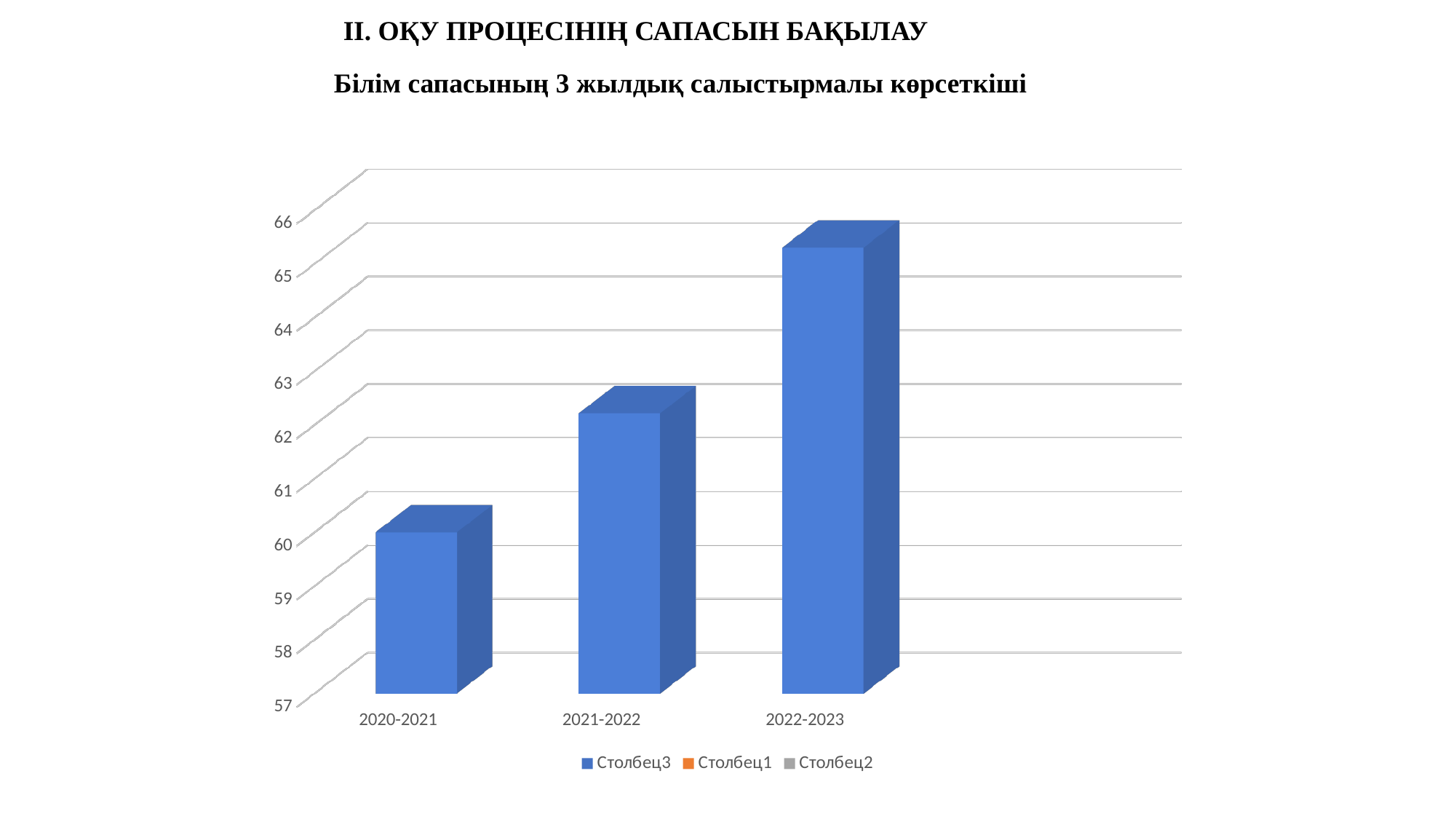
Which is larger, the value for 2021-2022 or the value for 2020-2021? 2021-2022 How many categories (academic years) are shown on the x axis? 3 Do the values rise or fall from 2020-2021 to 2022-2023? Rise Is the value for 2021-2022 greater or less than 61? greater What kind of chart is shown on the slide? Bar chart Is the value for 2022-2023 greater or less than 64? greater What is the title of the chart? Білім сапасының 3 жылдық салыстырмалы көрсеткіші How many series does the legend list? 3 Is the value for 2020-2021 greater or less than 62? less Which academic year has the lowest bar? 2020-2021 Which academic year has the highest bar? 2022-2023